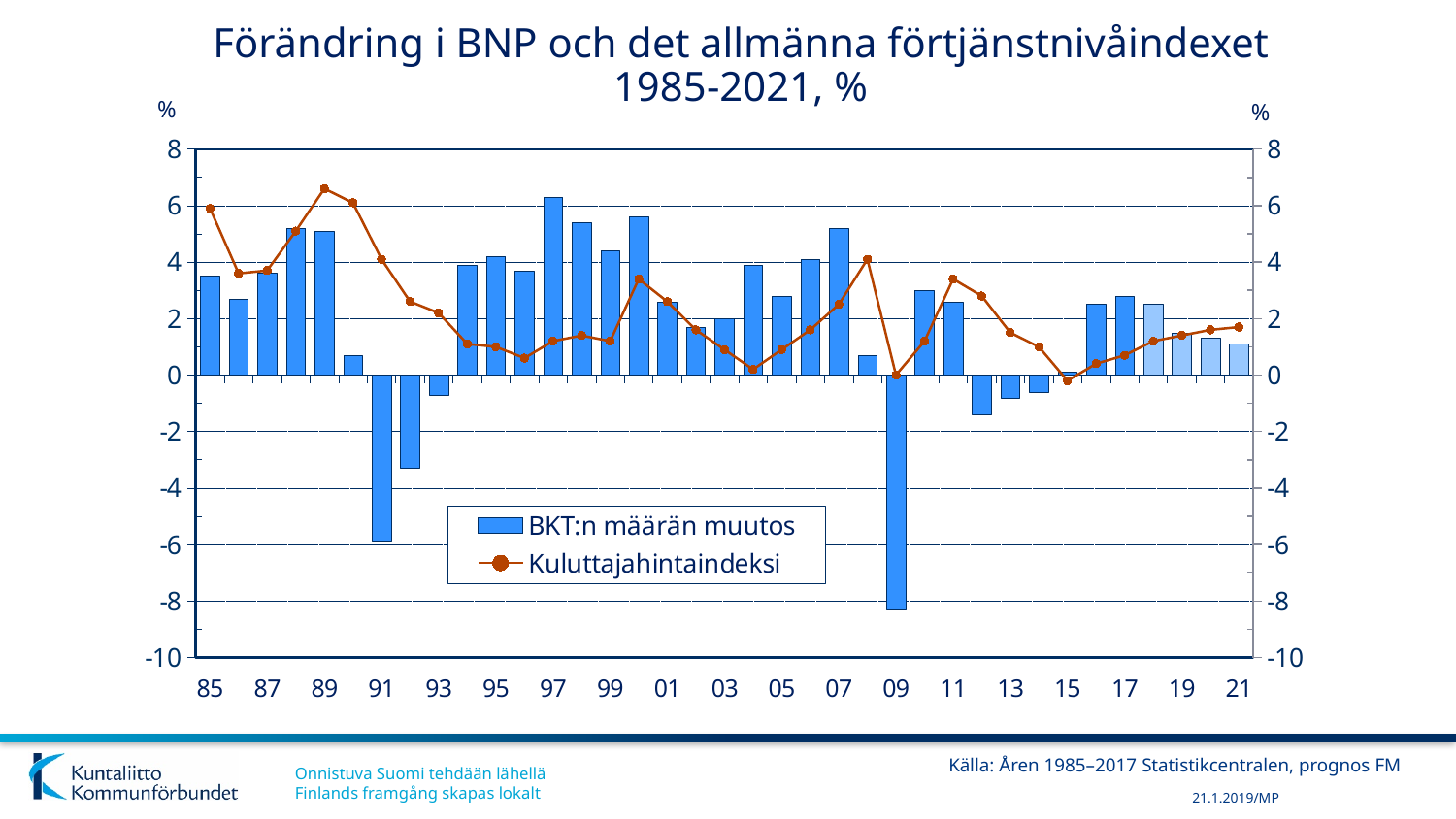
What kind of chart is shown on the slide? A combined bar and line chart How many series does the legend list? 2 What are the two series named in the legend? BKT:n määrän muutos and Kuluttajahintaindeksi In which year is the BKT:n määrän muutos bar highest? 1997 In which year does the Kuluttajahintaindeksi line reach its highest point? 1989 Is the BKT:n määrän muutos value for 2009 greater or less than -6? less In which year is the BKT:n määrän muutos bar lowest? 2009 How many years are covered by the bars on the chart? 37 Is the BKT:n määrän muutos value for 1991 greater or less than -4? less Does the Kuluttajahintaindeksi line rise or fall from 1989 to 1996? fall Which year has the larger Kuluttajahintaindeksi value, 1985 or 1995? 1985 Is the Kuluttajahintaindeksi value for 1989 greater or less than 6? greater